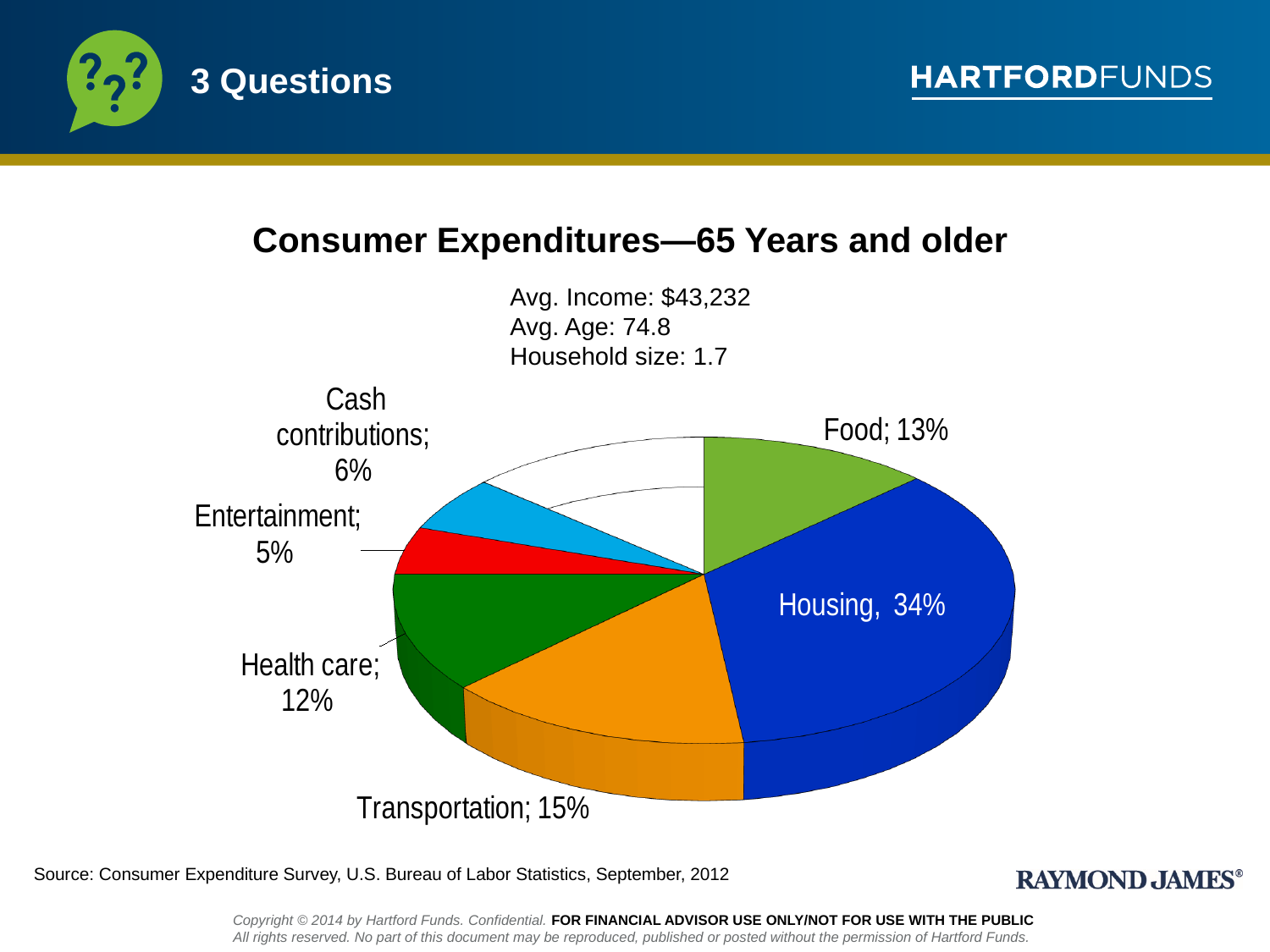
What kind of chart is shown on the slide? Pie chart What share of expenditures is labeled for Food? 13% Which labeled category has the smallest share of the pie? Entertainment Which is larger, the share for Transportation or the share for Health care? Transportation What is the value shown for Transportation? 15% What is the title of the chart? Consumer Expenditures—65 Years and older Which labeled category has the largest share of the pie? Housing What is the value for Cash contributions? 6% What percentage of consumer expenditures goes to Housing? 34% What percentage is shown for Health care? 12% What average income is stated above the chart? $43,232 What is the difference in percentage points between Housing and Food? 21